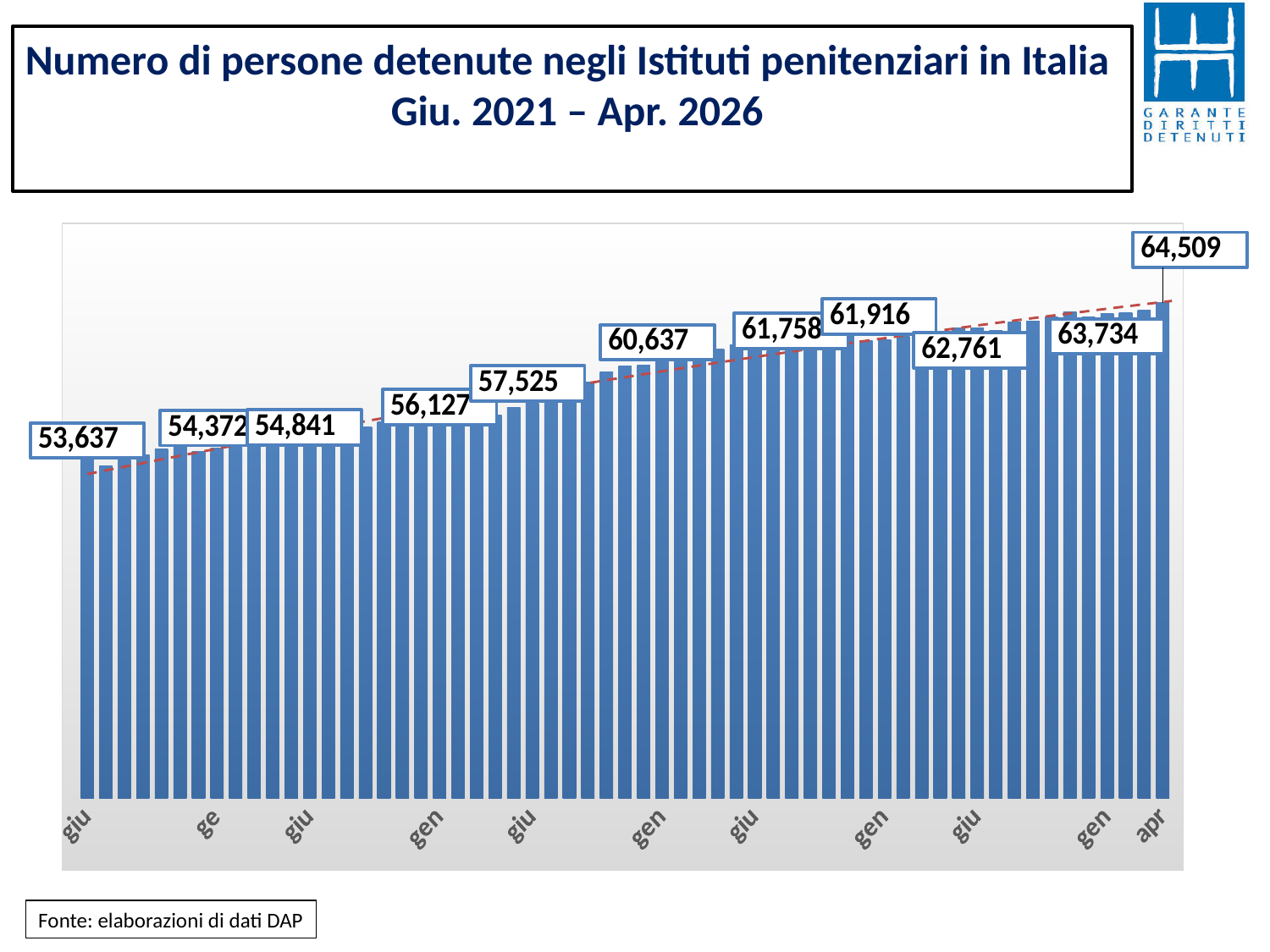
What is the lowest value labelled on the chart? 53,637 What is the difference between the value for apr 2026 (64,509) and the value for giu 2021 (53,637)? 10,872 What is the highest value labelled on the chart? 64,509 What is the title of the chart on the slide? Numero di persone detenute negli Istituti penitenziari in Italia Giu. 2021 – Apr. 2026 What is the number of detained persons shown for the first bar (giu 2021)? 53,637 Do the values generally rise or fall from left to right along the x axis? rise What is the number of detained persons shown for the last bar (apr 2026)? 64,509 What kind of chart is shown on the slide? bar chart What is the difference between the labelled values 61,916 and 61,758? 158 What is the difference between the labelled values 63,734 and 62,761? 973 Which is larger, the value for giu 2021 or the value for apr 2026? apr 2026 How many data labels are printed on the chart? 11